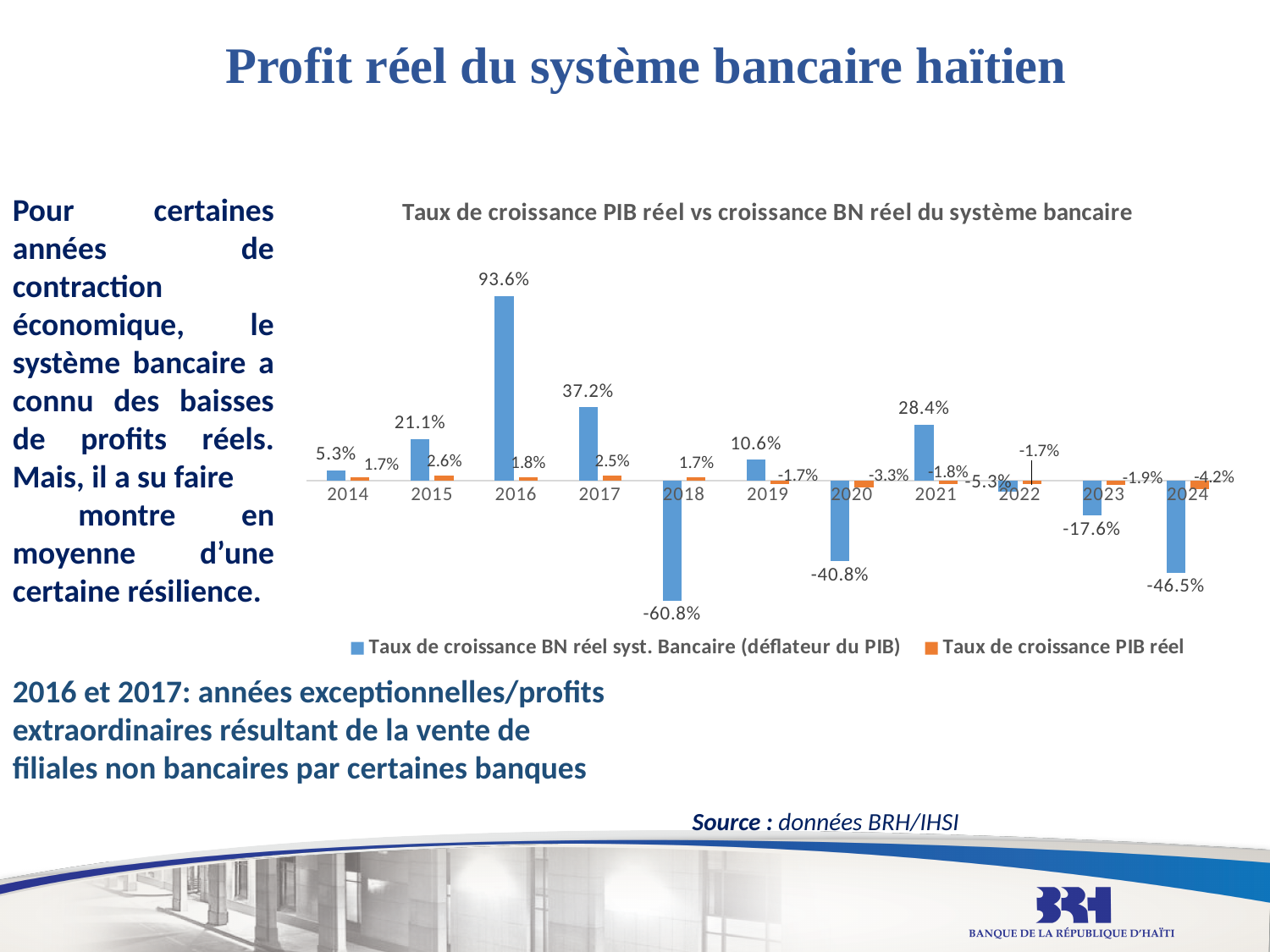
What is the value of 'Taux de croissance PIB réel' for 2015? 2.6% Which year has the lowest value for 'Taux de croissance PIB réel'? 2024 Which is larger: the 'Taux de croissance BN réel syst. Bancaire' value for 2021 or for 2015? 2021 Which year has the highest value for 'Taux de croissance BN réel syst. Bancaire'? 2016 What is the value of 'Taux de croissance PIB réel' for 2020? -3.3% How many years are shown on the x axis of the chart? 11 How many series does the chart legend list? 2 What type of chart is shown on the slide? Bar chart Which year has the lowest value for 'Taux de croissance BN réel syst. Bancaire'? 2018 What is the difference between the 'Taux de croissance BN réel syst. Bancaire' values for 2016 and 2017? 56.4 percentage points What is the value of 'Taux de croissance BN réel syst. Bancaire' for 2016? 93.6% What is the value of 'Taux de croissance BN réel syst. Bancaire' for 2018? -60.8%